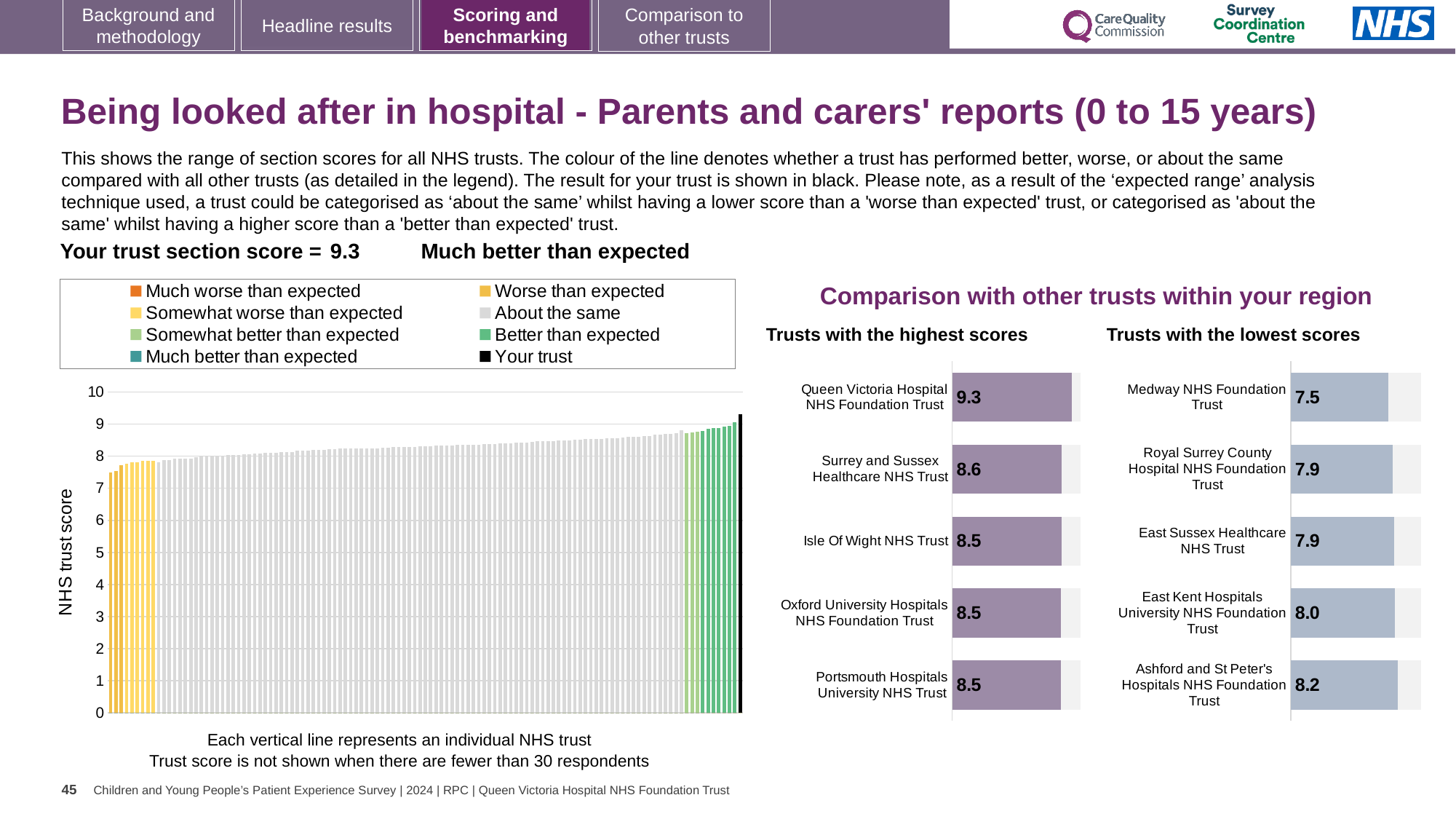
In the 'Trusts with the highest scores' chart, what is the difference between the scores of Queen Victoria Hospital NHS Foundation Trust and Surrey and Sussex Healthcare NHS Trust? 0.7 How many trusts are shown in the 'Trusts with the lowest scores' chart? 5 In the 'Trusts with the lowest scores' chart, which trust has the lowest score? Medway NHS Foundation Trust In the 'Trusts with the lowest scores' chart, what is the score for Medway NHS Foundation Trust? 7.5 How many entries does the legend above the large chart on the left list? 8 In the 'Trusts with the highest scores' chart, which trust has the highest score? Queen Victoria Hospital NHS Foundation Trust In the large chart on the left showing all NHS trusts, do the bar values rise or fall from left to right along the x axis? rise In the 'Trusts with the lowest scores' chart, what is the score for Ashford and St Peter's Hospitals NHS Foundation Trust? 8.2 In the large chart on the left showing all NHS trusts, is the value for the black bar (your trust) greater or less than 9? greater In the 'Trusts with the highest scores' chart, what is the score for Queen Victoria Hospital NHS Foundation Trust? 9.3 In the 'Trusts with the lowest scores' chart, which has the larger score: Medway NHS Foundation Trust or East Kent Hospitals University NHS Foundation Trust? East Kent Hospitals University NHS Foundation Trust In the 'Trusts with the highest scores' chart, what is the score for Surrey and Sussex Healthcare NHS Trust? 8.6